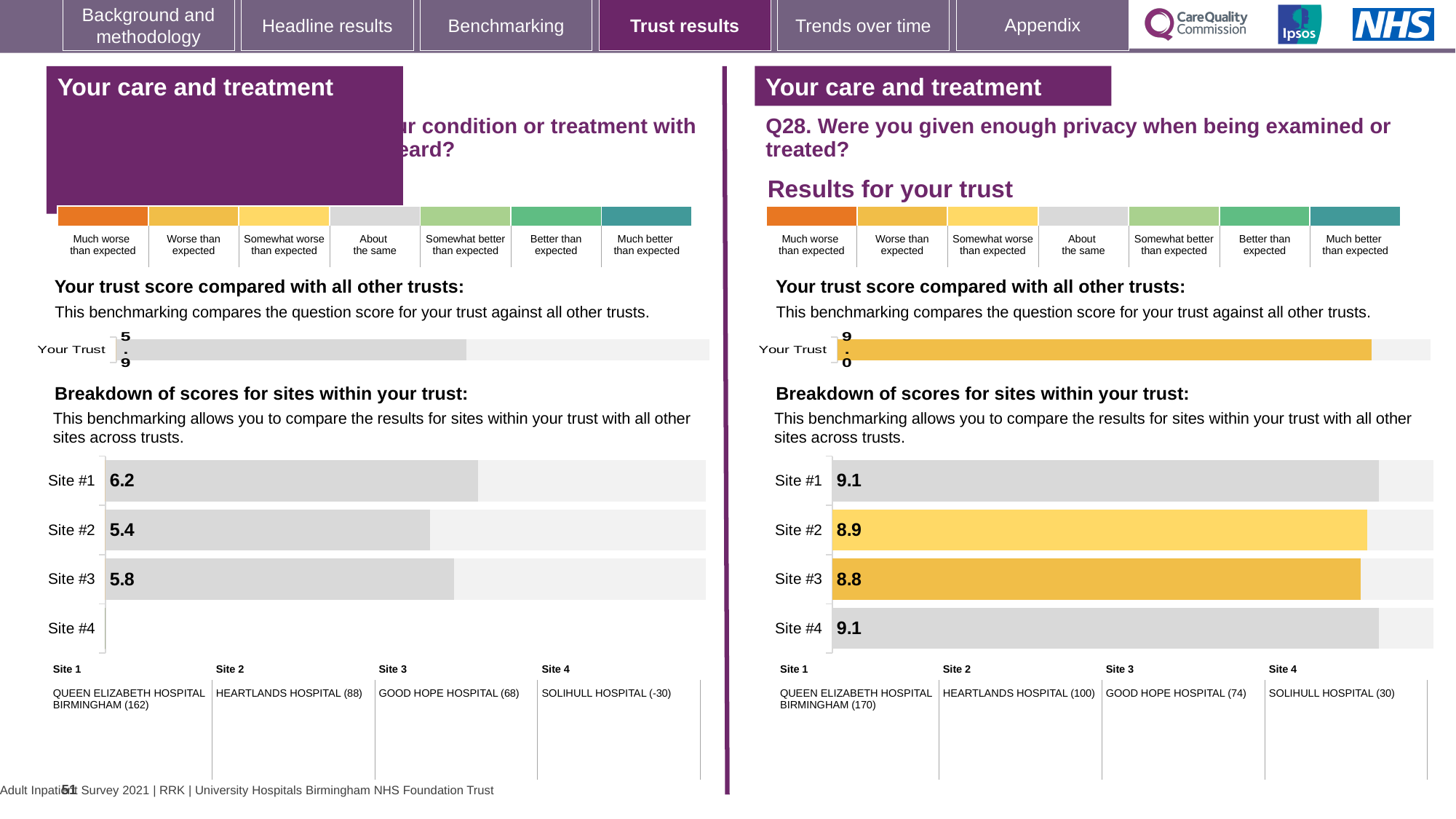
In the left-hand site breakdown chart, what is the score for Site #1? 6.2 In the right-hand chart for Q28, what is the difference between the scores for Site #2 and Site #3? 0.1 In the left-hand site breakdown chart, what is the score for Site #2? 5.4 In the left-hand site breakdown chart, which site has the lowest score among those with a bar shown? Site #2 What is the 'Your Trust' score shown in the right-hand panel for Q28? 9.0 In the right-hand chart for Q28, which site has the lowest score? Site #3 In the left-hand site breakdown chart, what is the difference between the scores for Site #1 and Site #2? 0.8 In the right-hand chart for Q28, which is larger: the score for Site #1 or the score for Site #2? Site #1 In the right-hand chart for Q28 (privacy when being examined or treated), what is the score for Site #1? 9.1 What type of chart is used for the breakdown of scores for sites within your trust? Bar chart In the right-hand chart for Q28, what is the score for Site #3? 8.8 In the left-hand site breakdown chart, which is larger: the score for Site #3 or the score for Site #2? Site #3